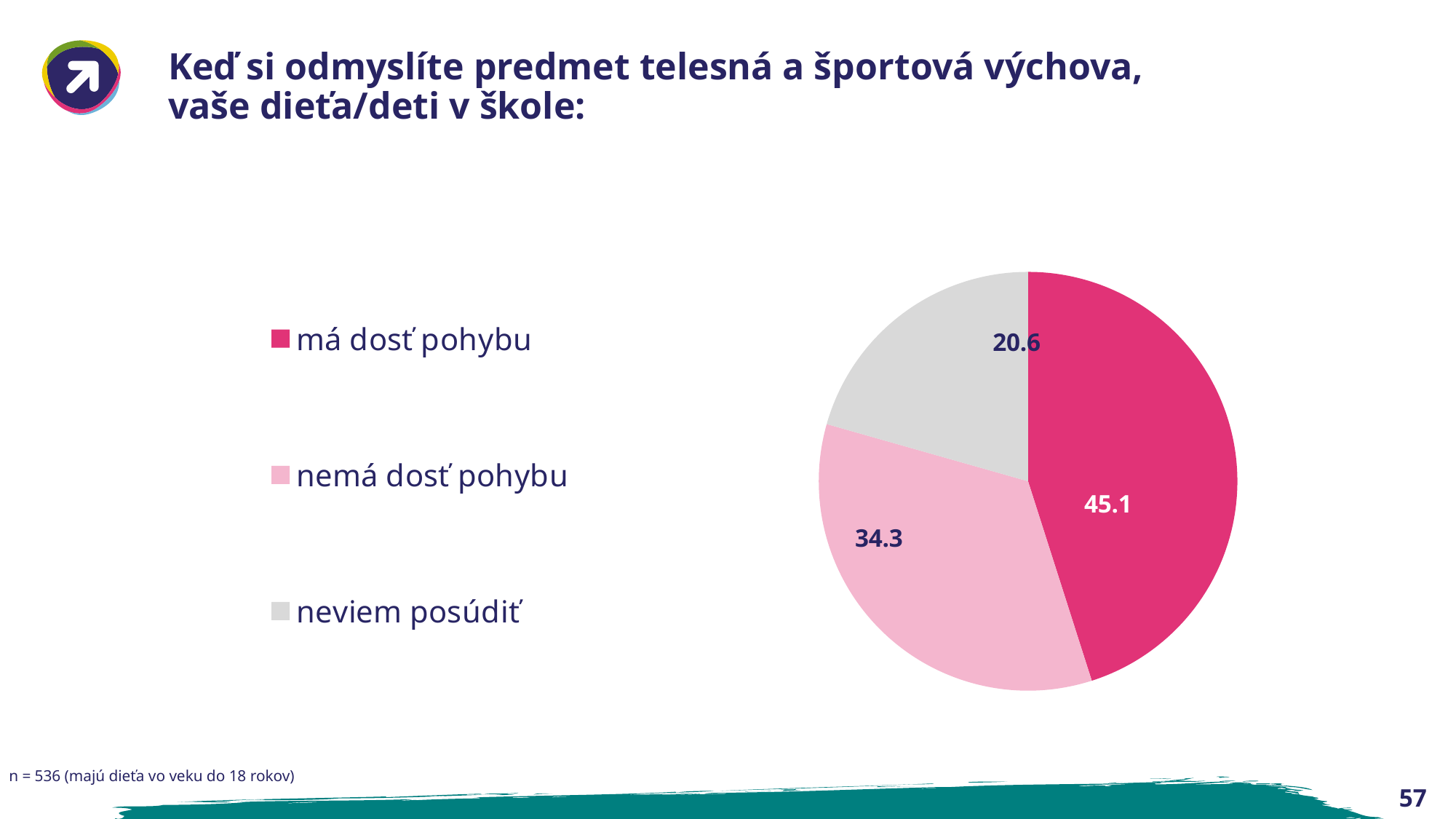
What is the value for "nemá dosť pohybu"? 34.3 What is the difference between the values for "má dosť pohybu" and "nemá dosť pohybu"? 10.8 How many entries does the legend list? 3 Which is larger: the value for "nemá dosť pohybu" or "neviem posúdiť"? nemá dosť pohybu How many slices does the pie chart have? 3 What type of chart is shown on the slide? pie chart Which category has the largest slice? má dosť pohybu What colour is the slice for "neviem posúdiť"? grey What is the value for "má dosť pohybu"? 45.1 What is the value for "neviem posúdiť"? 20.6 Which category has the smallest slice? neviem posúdiť What is the difference between the values for "nemá dosť pohybu" and "neviem posúdiť"? 13.7